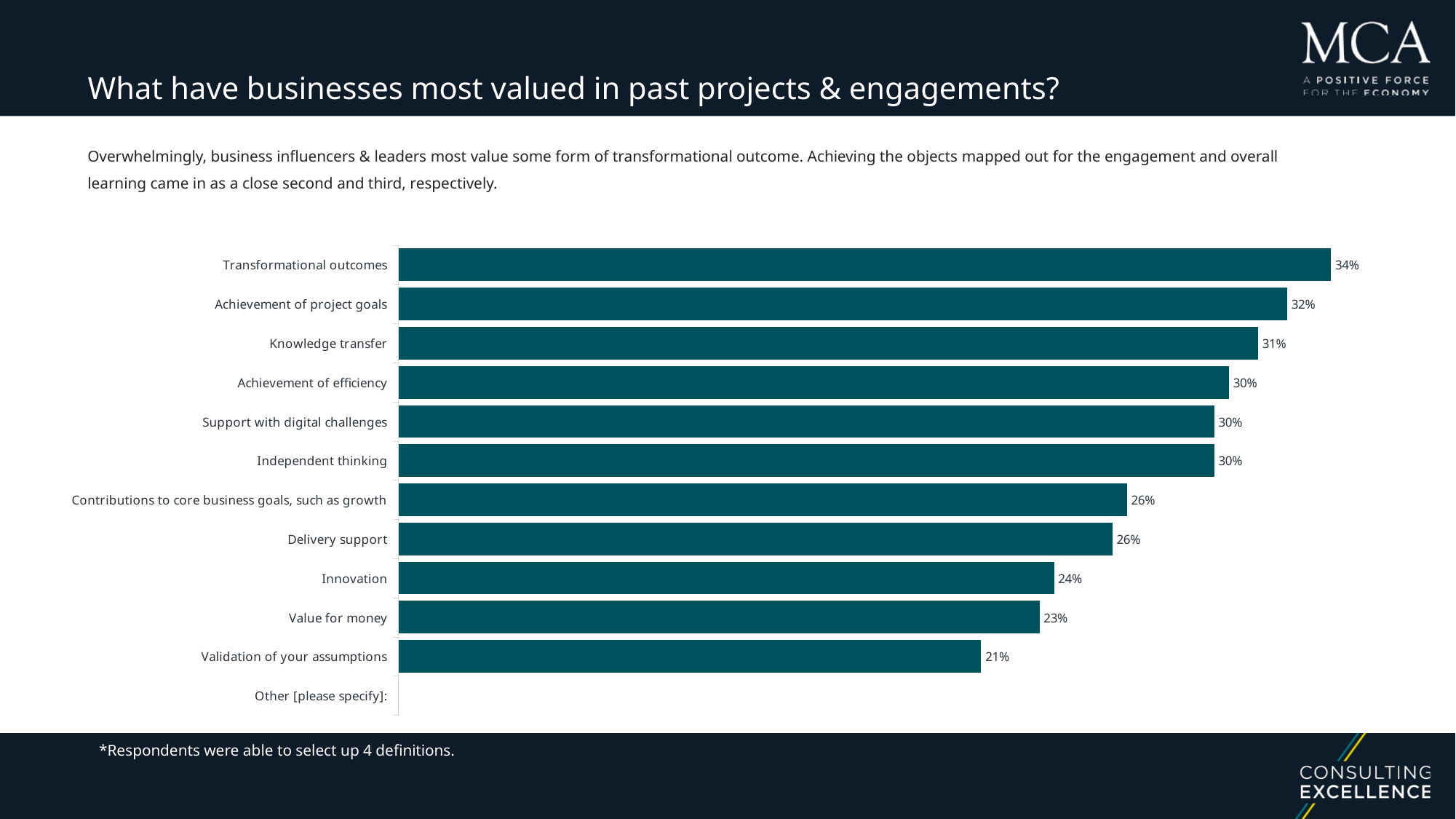
How many categories are listed on the vertical axis of the chart? 12 What kind of chart is shown on the slide? Bar chart Which category has the highest value? Transformational outcomes What is the value for Transformational outcomes? 34% What is the value for Knowledge transfer? 31% What is the difference between the values for Transformational outcomes and Validation of your assumptions? 13 percentage points What is the value for Innovation? 24% What is the value for Validation of your assumptions? 21% Which category with a labelled bar has the lowest value? Validation of your assumptions What is the title of the slide containing the chart? What have businesses most valued in past projects & engagements? Which is larger, the value for Knowledge transfer or the value for Delivery support? Knowledge transfer What is the difference between the values for Transformational outcomes and Achievement of project goals? 2 percentage points